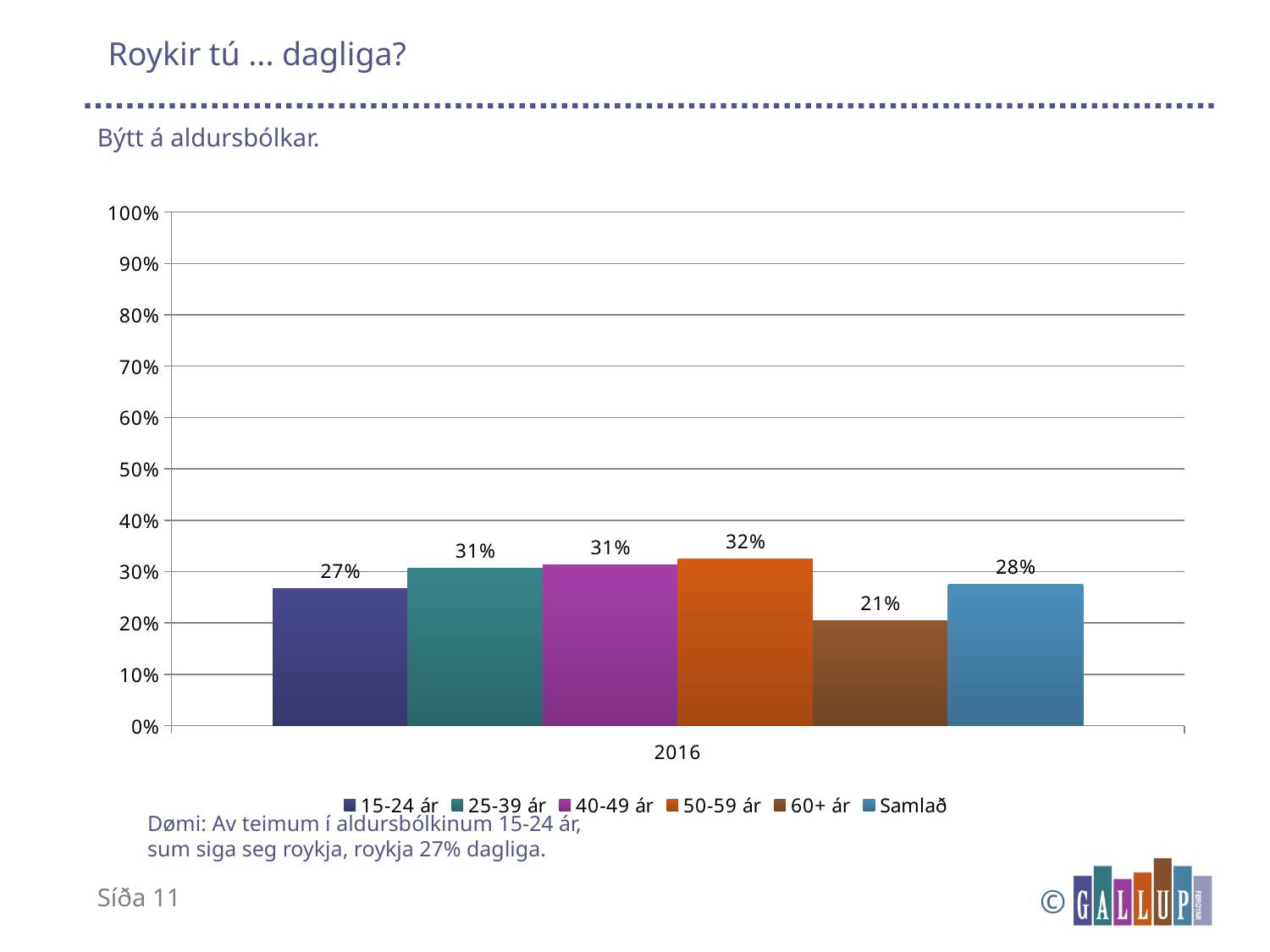
Which series has the lowest value? 60+ ár Which series has the highest value? 50-59 ár What is the difference between the values for 50-59 ár and 60+ ár? 11% What is the value for the 15-24 ár series? 27% How many series does the legend list? 6 What year is shown on the x axis? 2016 Which is larger, the value for 15-24 ár or the value for 25-39 ár? 25-39 ár Is the value for 60+ ár greater or less than 30%? less What is the value for the 50-59 ár series? 32% What kind of chart is shown on the slide? bar chart What is the value for the Samlað series? 28% What is the value for the 60+ ár series? 21%